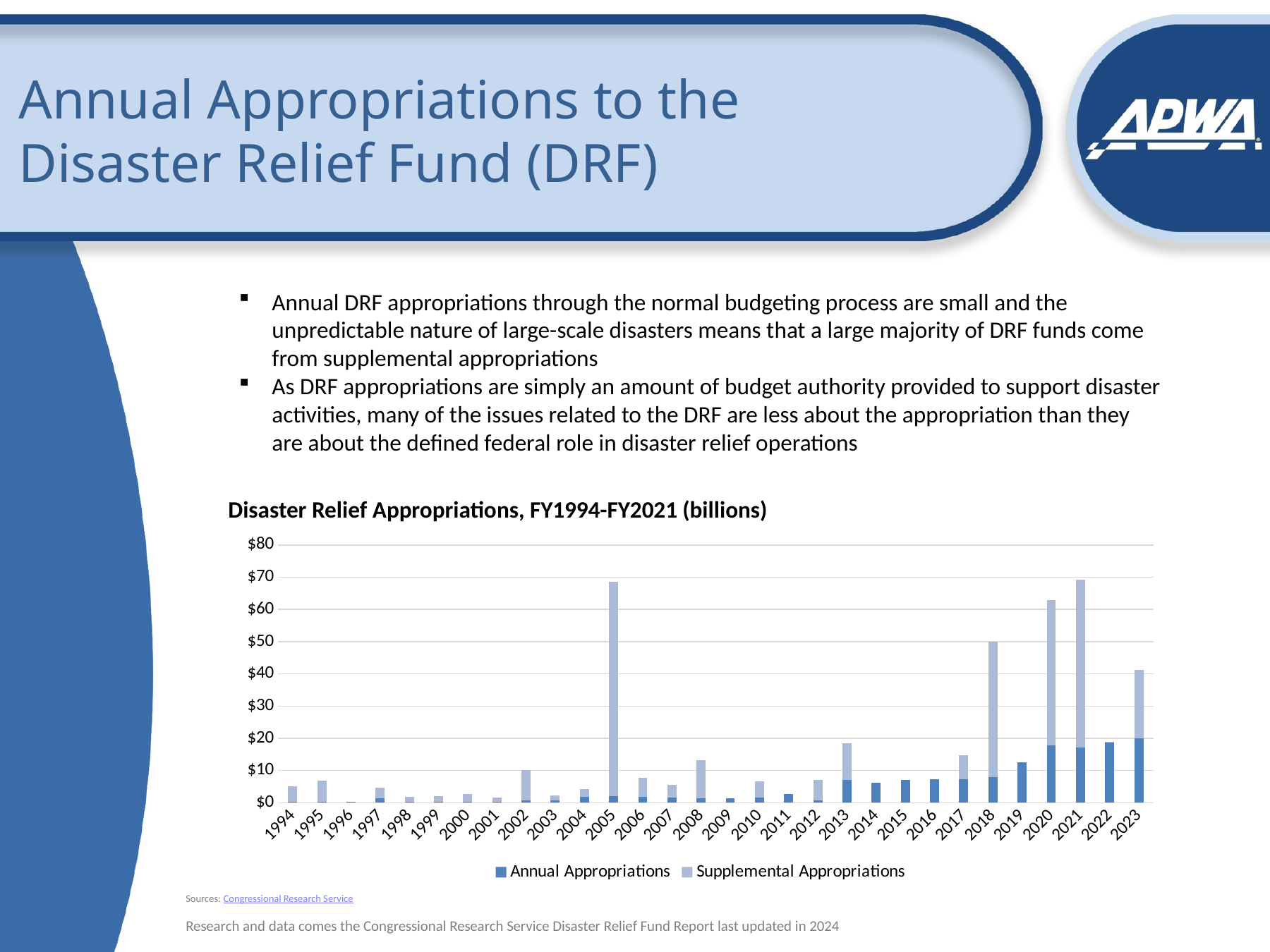
Which year has the larger total appropriations, 2005 or 2013? 2005 Is the total appropriations value for 2005 greater or less than $60? greater Which year has the lowest total appropriations in the chart? 1996 Which series is shown in the lighter blue colour in the chart? Supplemental Appropriations What is the title of the chart? Disaster Relief Appropriations, FY1994-FY2021 (billions) How many fiscal years are shown along the x axis of the chart? 30 Which year has the larger total appropriations, 2020 or 2018? 2020 How many series does the legend list in the Disaster Relief Appropriations chart? 2 What kind of chart is shown on the slide? Stacked bar chart Is the total appropriations value for 2008 greater or less than $10? greater Is the total appropriations value for 2023 greater or less than $30? greater